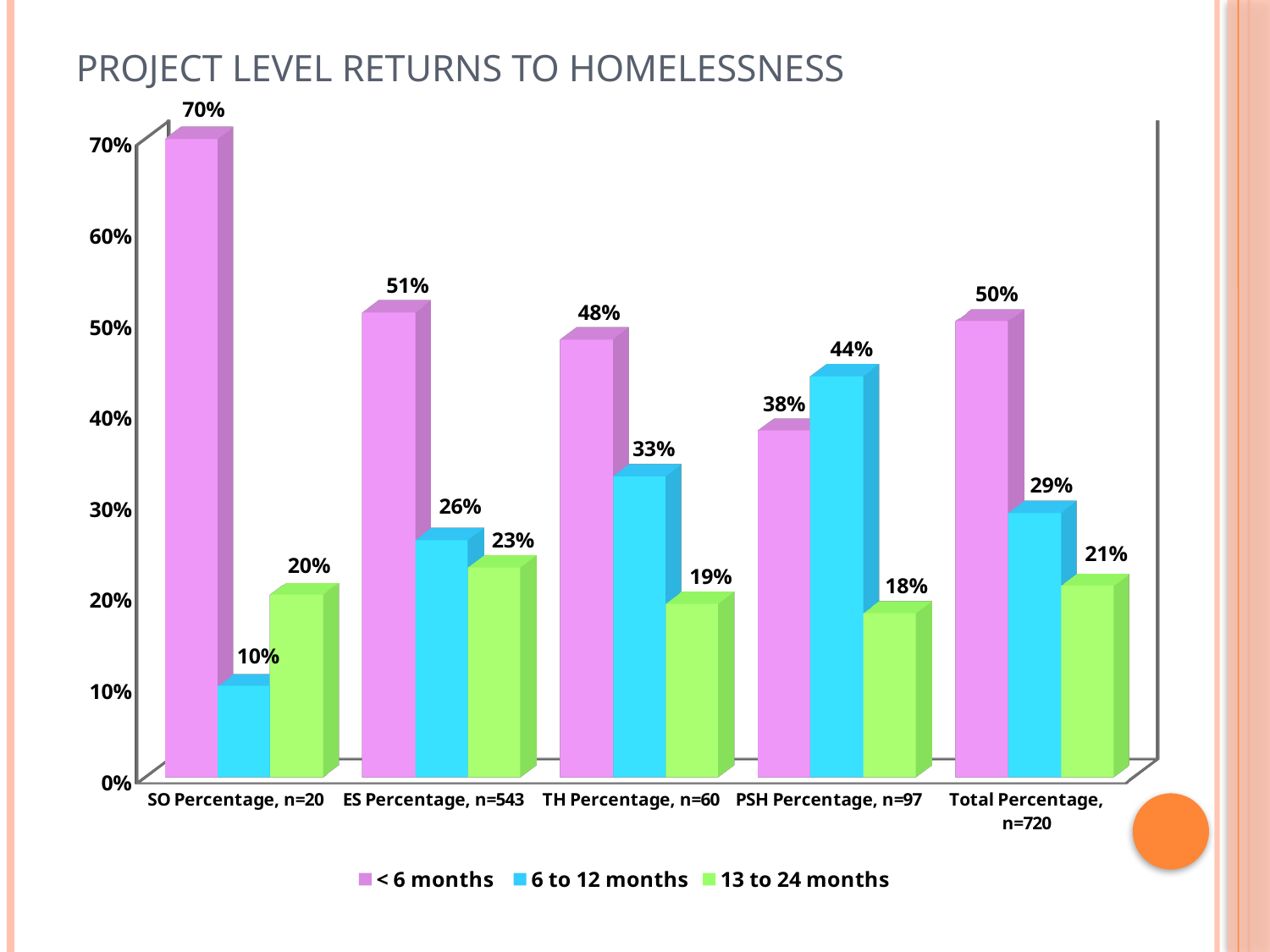
What kind of chart is shown on the slide? Bar chart In the PSH Percentage, n=97 category, which is larger: '< 6 months' or '6 to 12 months'? 6 to 12 months How many categories are shown on the x axis? 5 Which category has the highest '< 6 months' value? SO Percentage, n=20 What is the difference between the '< 6 months' and '6 to 12 months' values in the TH Percentage, n=60 category? 15% What is the value for '< 6 months' in the SO Percentage, n=20 category? 70% What is the value for '13 to 24 months' in the ES Percentage, n=543 category? 23% How many series does the legend list? 3 Which category has the lowest '6 to 12 months' value? SO Percentage, n=20 What is the value for '13 to 24 months' in the Total Percentage, n=720 category? 21% What is the title of the slide? Project Level Returns to Homelessness What is the value for '6 to 12 months' in the PSH Percentage, n=97 category? 44%